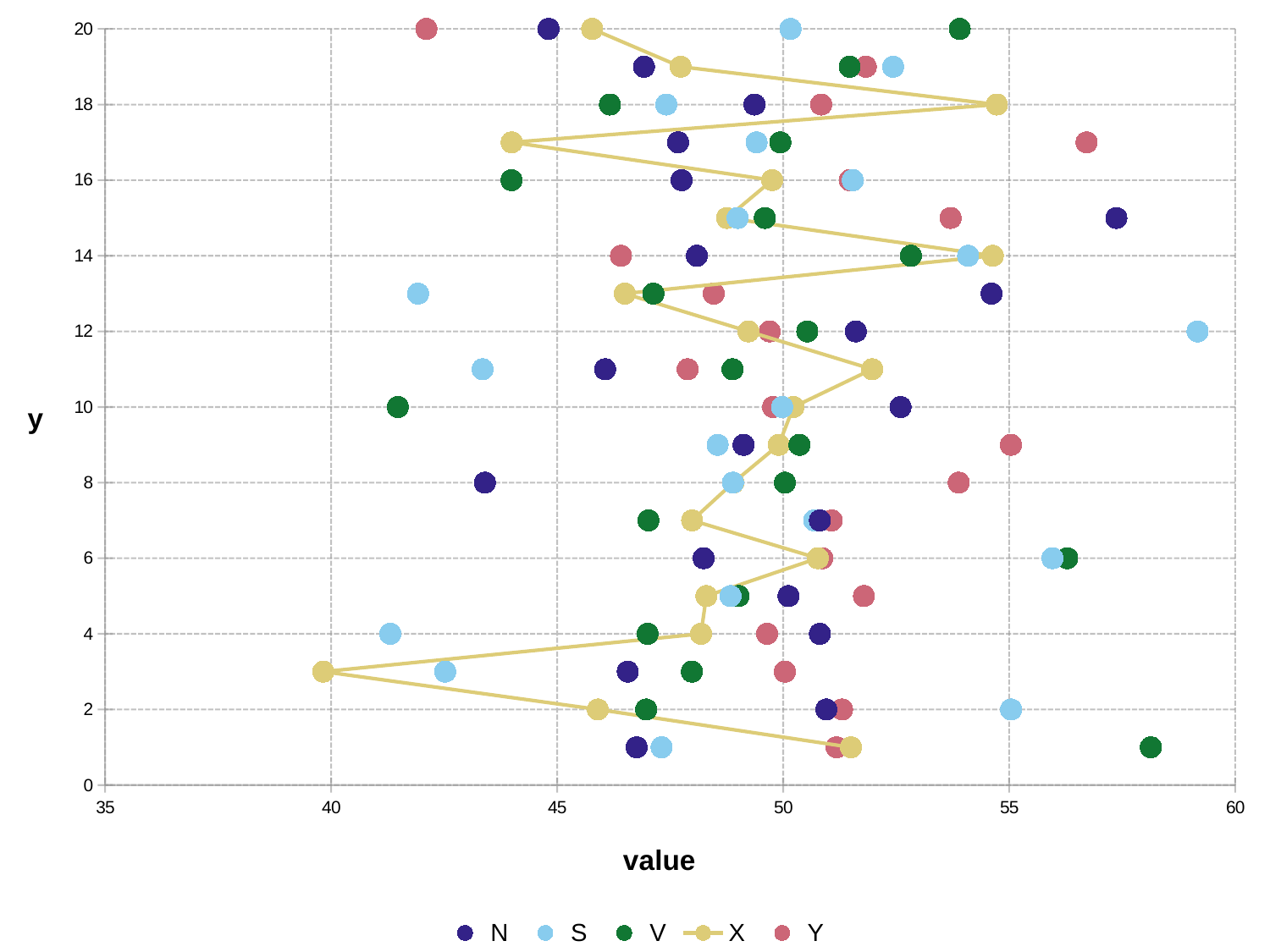
How many series does the legend list? 5 Is the value of the V series point at y = 1 greater or less than 55? greater Is the value of the X series point at y = 17 greater or less than 45? less What is the title of the horizontal axis? value Is the value of the N series point at y = 8 greater or less than 45? less Which series is drawn with lines connecting its points? X Which series contains the point with the lowest value on the chart? X What kind of chart is shown on the slide? scatter chart How many points does the X series have? 20